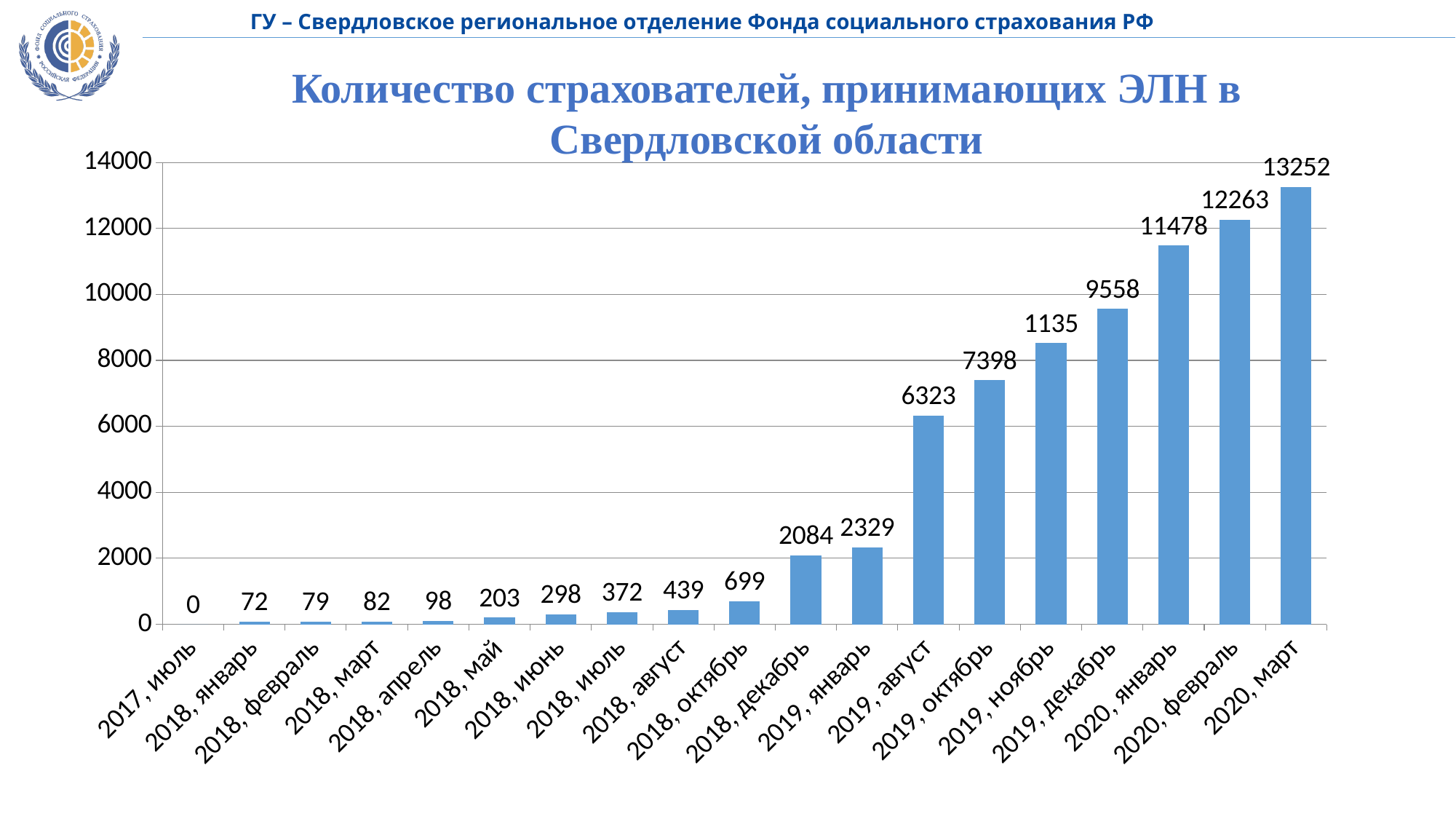
What kind of chart is shown on the slide? bar chart Which category has the lowest value? 2017, июль How many categories are shown on the x axis? 19 What is the value for 2018, май? 203 What is the difference between the values for 2020, март and 2020, февраль? 989 Which is larger, the value for 2019, декабрь or the value for 2019, октябрь? 2019, декабрь What is the value for 2019, август? 6323 Which category has the highest value? 2020, март Do the values generally rise or fall from left to right along the x axis? rise What is the value for 2020, март? 13252 What is the value for 2018, октябрь? 699 Is the value for 2020, январь greater or less than 10000? greater